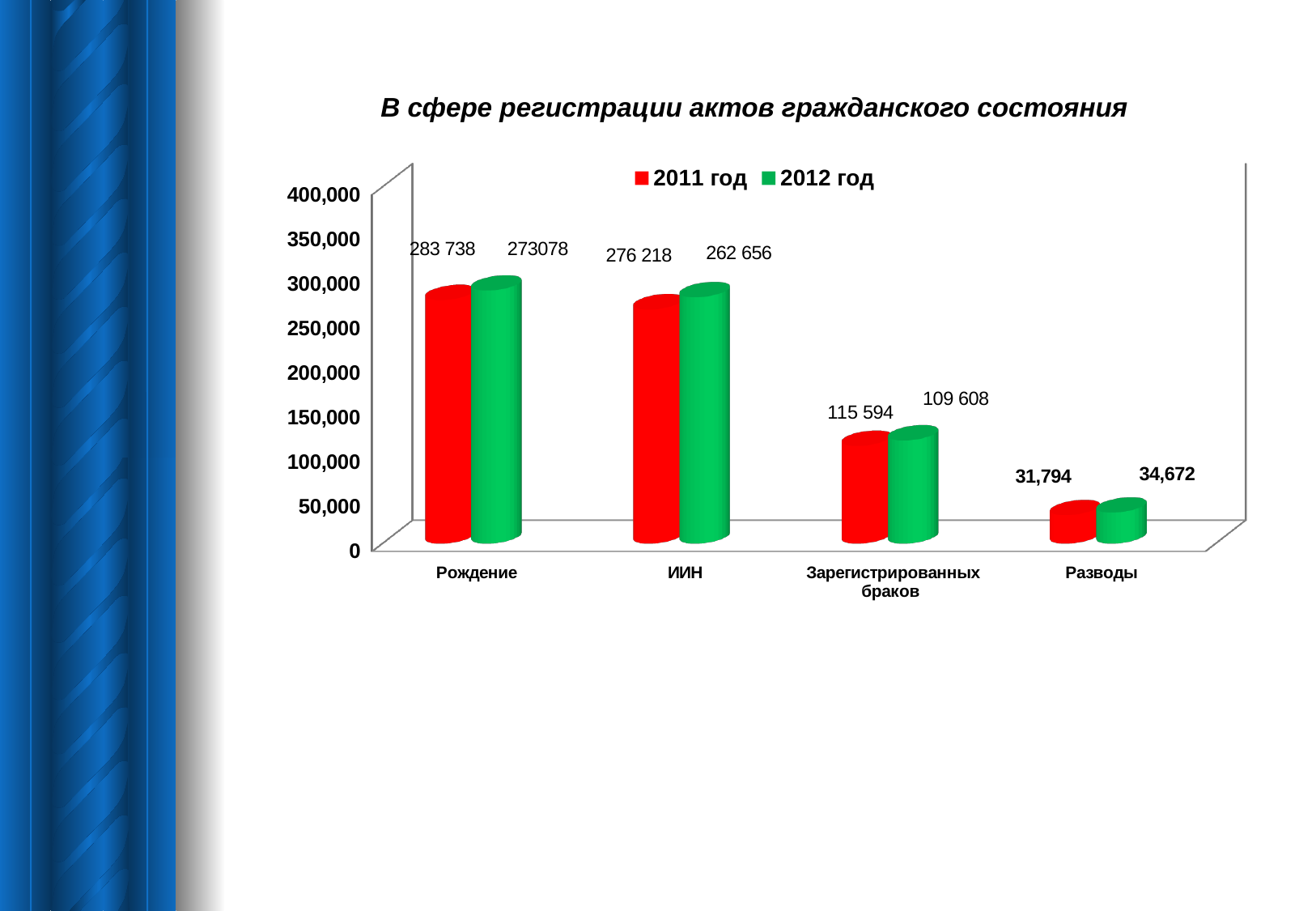
How many categories are shown on the x axis? 4 What is the difference between the 2011 год and 2012 год values for ИИН? 13 562 What is the difference between the 2012 год and 2011 год values for Разводы? 2,878 How many series does the legend list? 2 What is the value for Разводы in the 2012 год series? 34,672 Which category has the lowest value in the 2012 год series? Разводы Which category has the highest value in the 2011 год series? Рождение What kind of chart is shown on the slide? Bar chart